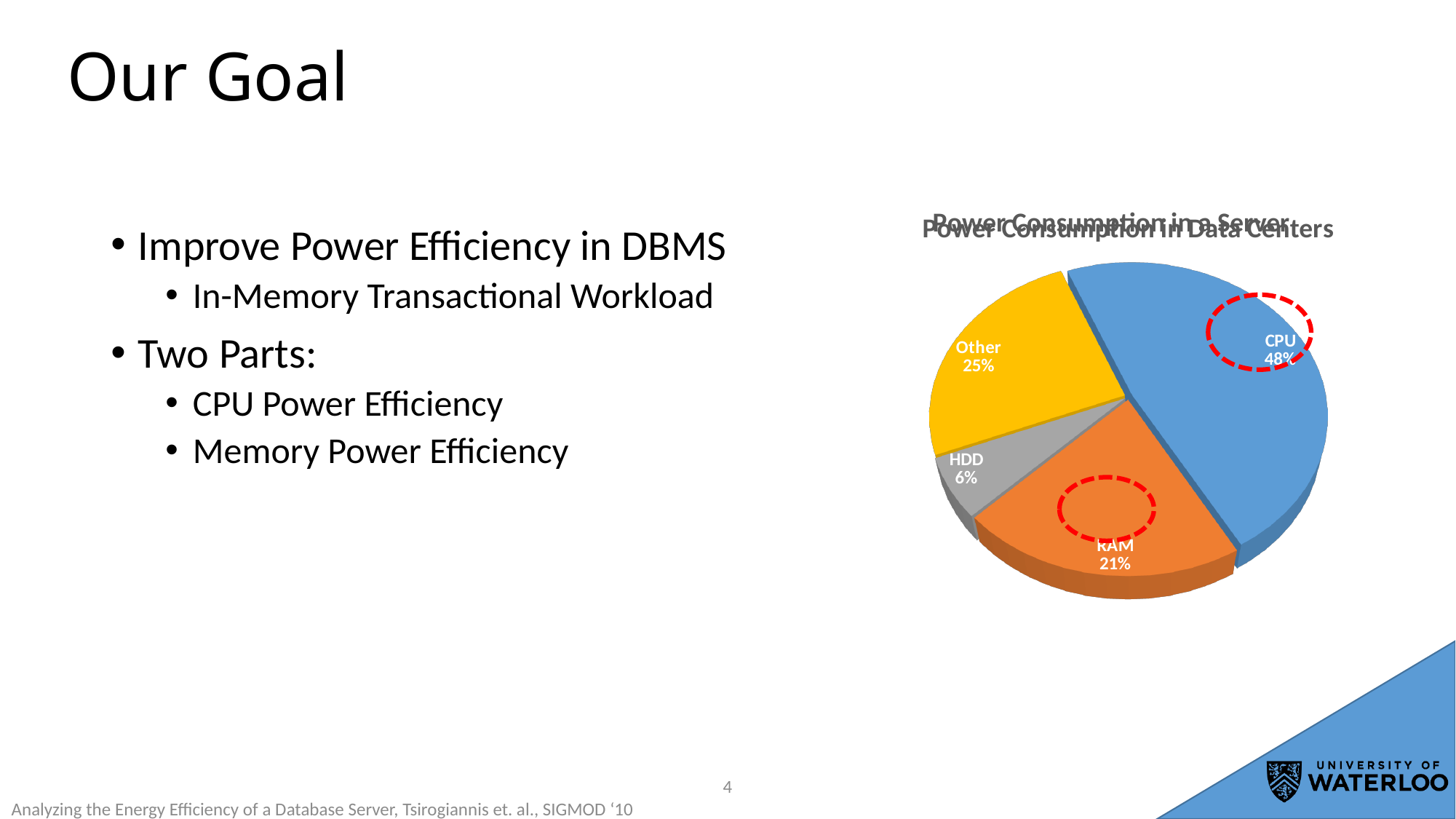
What is the combined share of the CPU and RAM slices? 69% What share of power consumption does the RAM slice represent? 21% Which component has the largest share of power consumption in the pie chart? CPU What share of power consumption does the HDD slice represent? 6% Which two slices of the pie chart are highlighted with red dashed circles? CPU and RAM What is the difference in percentage points between the CPU and RAM slices? 27 What share of power consumption does the CPU slice represent? 48% What kind of chart is shown on the slide? pie chart Which component has the smallest share of power consumption in the pie chart? HDD What share of power consumption does the Other slice represent? 25% Which slice is larger, Other or RAM? Other How many slices does the pie chart have? 4